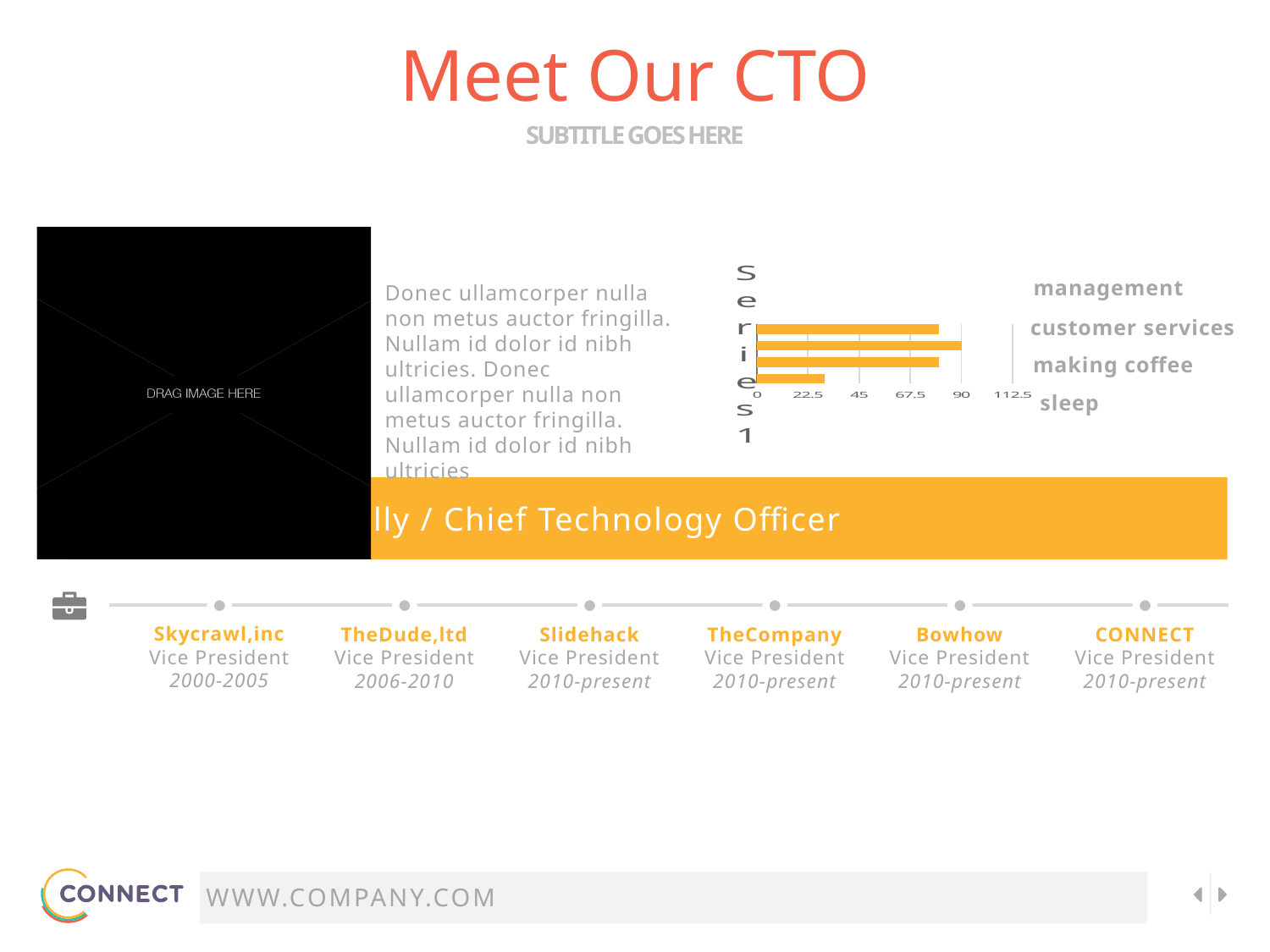
What is the highest tick value shown on the chart's horizontal axis? 112.5 Is the value for customer services greater or less than 67.5? greater What is the name of the series shown in the chart legend? Series 1 Is the value for making coffee greater or less than 45? greater What kind of chart is shown on the slide? bar chart Which category has the longest bar in the chart? customer services Which is larger, the value for customer services or the value for sleep? customer services How many series does the chart's legend list? 1 Is the value for management greater or less than 67.5? greater How many bars does the chart show? 4 Which category has the shortest bar in the chart? sleep